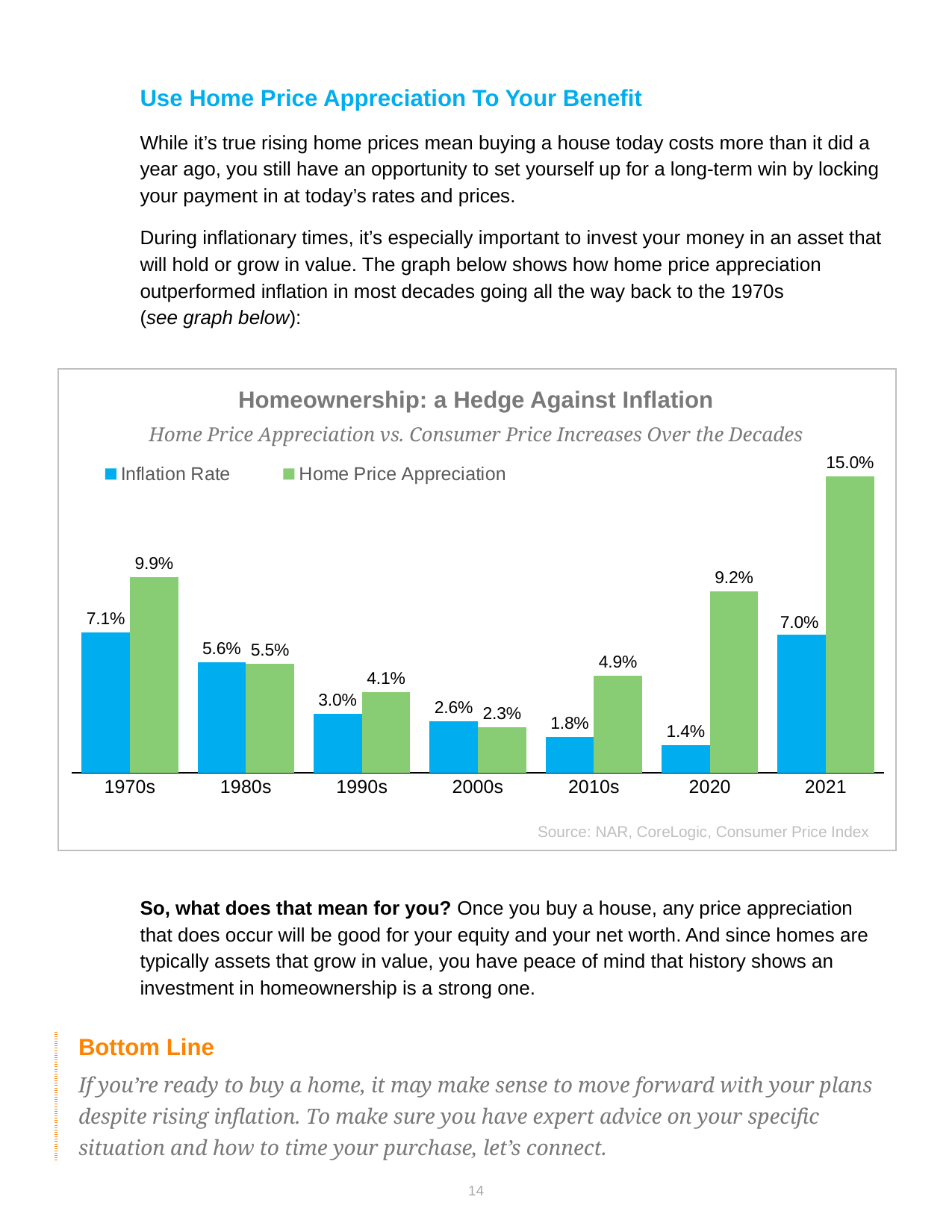
What kind of chart is shown? Bar chart What is the Inflation Rate for 2020? 1.4% How many series does the legend list? 2 What is the Inflation Rate for the 1970s? 7.1% What is the title of the chart? Homeownership: a Hedge Against Inflation In the 2010s, which is larger: the Inflation Rate or Home Price Appreciation? Home Price Appreciation How many categories are shown on the x axis? 7 Which category has the highest Home Price Appreciation? 2021 In the 1980s, which is larger: the Inflation Rate or Home Price Appreciation? Inflation Rate What is the Home Price Appreciation value for 2021? 15.0% Which category has the lowest Inflation Rate? 2020 What is the difference between Home Price Appreciation and Inflation Rate in 2020? 7.8%